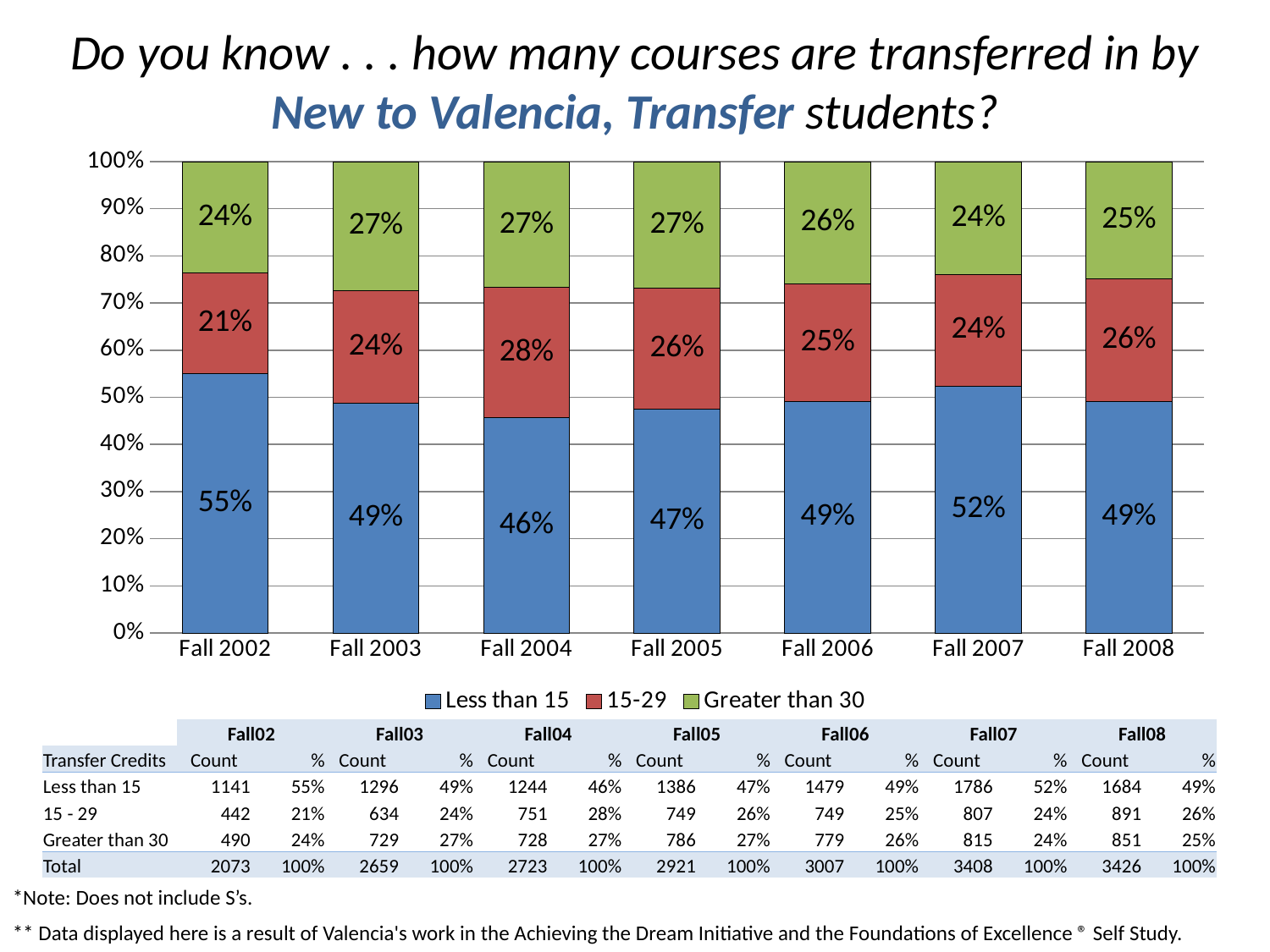
What type of chart is shown on the slide? Stacked bar chart In which term is the 15-29 share the lowest? Fall 2002 What is the Greater than 30 share shown for Fall 2007? 24% How many series does the chart legend list? 3 How many terms are shown on the x axis of the chart? 7 What percentage of New to Valencia, Transfer students had Less than 15 transfer credits in Fall 2002? 55% What is the 15-29 transfer credits share for Fall 2004? 28% Which is larger in Fall 2003: the 15-29 share or the Greater than 30 share? Greater than 30 In which term is the Less than 15 share the lowest? Fall 2004 In which term is the Less than 15 share the highest? Fall 2002 What is the difference between the Less than 15 share in Fall 2002 and in Fall 2004? 9% Does the Less than 15 share rise or fall from Fall 2002 to Fall 2004? Fall